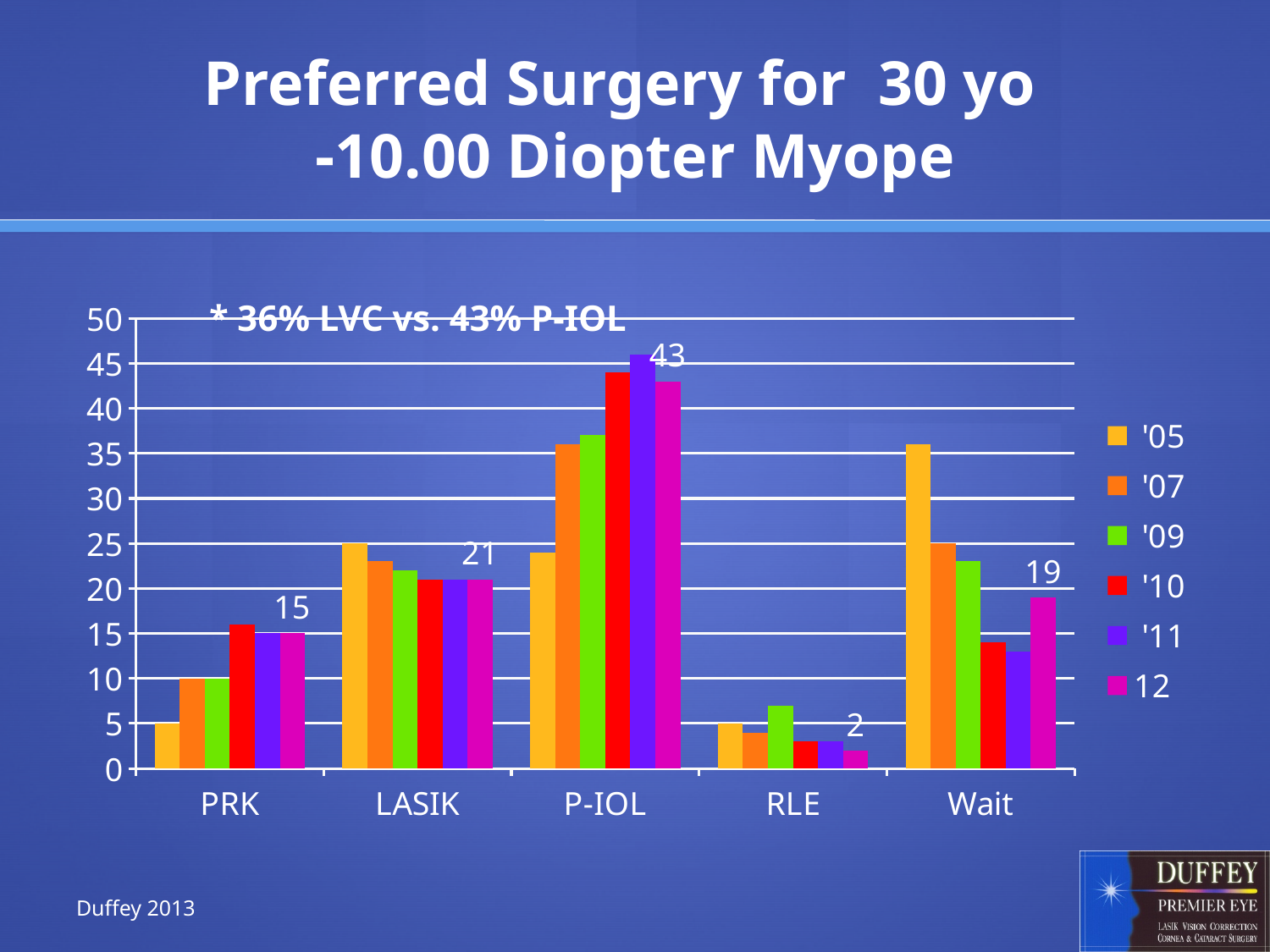
Is the value for Wait in the '05 series greater or less than 30? greater What is the difference between the 12 series values for P-IOL and LASIK? 22 What is the value for P-IOL in the 12 series? 43 What is the value for RLE in the 12 series? 2 How many series does the legend list? 6 How many categories are shown on the x axis? 5 What is the value for Wait in the 12 series? 19 Which category has the lowest value in the 12 series? RLE What is the value for PRK in the 12 series? 15 In the 12 series, which is larger: LASIK or Wait? LASIK What kind of chart is shown on the slide? bar chart Which category has the highest value in the 12 series? P-IOL